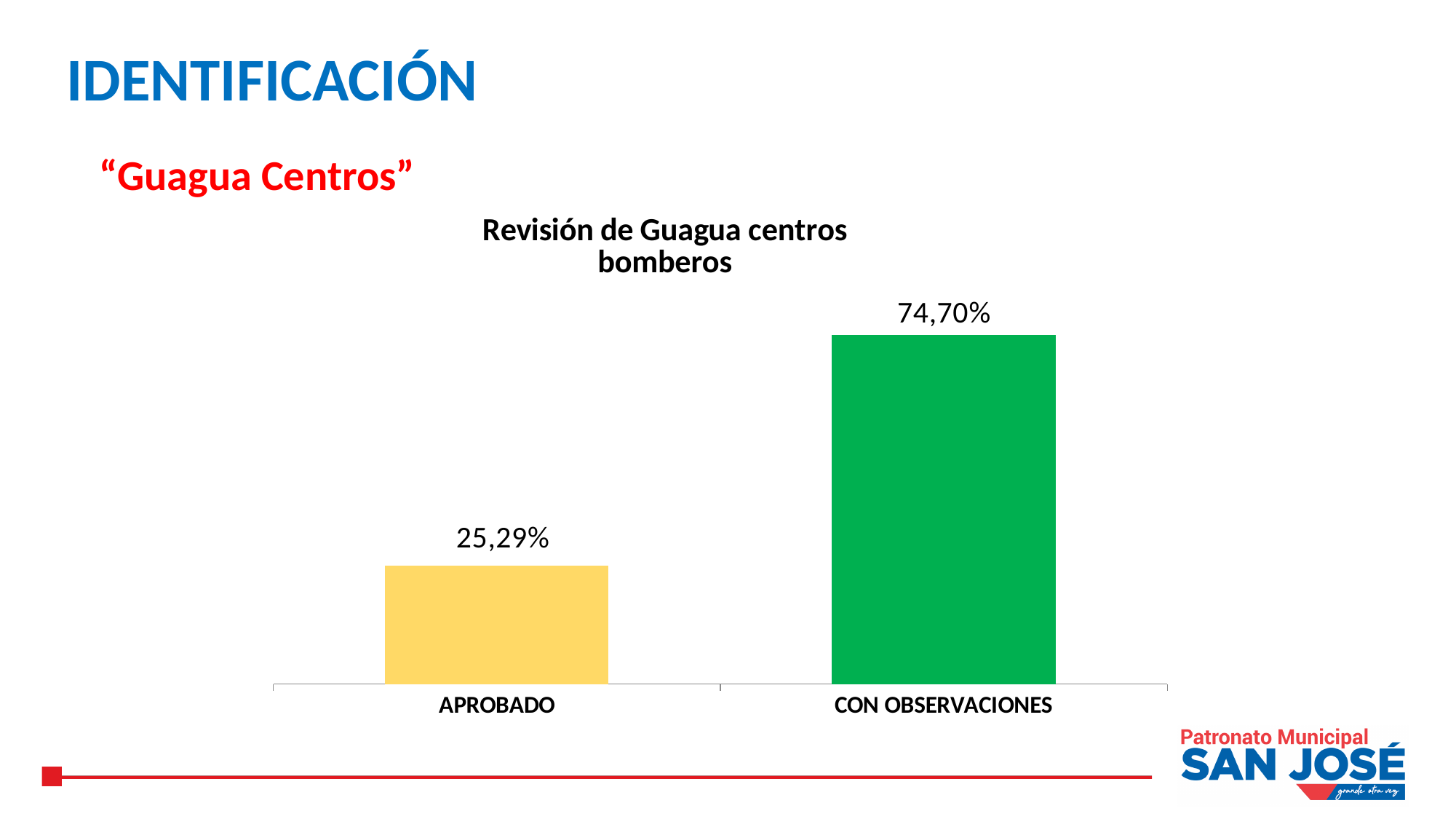
Which category has the lowest value? APROBADO How many categories are shown in the chart? 2 What is the difference between the values for CON OBSERVACIONES and APROBADO? 49,41% Which category has the highest value? CON OBSERVACIONES What is the value for APROBADO? 25,29% What colour is the bar for APROBADO? Yellow Which is larger, the value for APROBADO or the value for CON OBSERVACIONES? CON OBSERVACIONES What is the title of the chart? Revisión de Guagua centros bomberos What kind of chart is shown on the slide? Bar chart What is the value for CON OBSERVACIONES? 74,70%